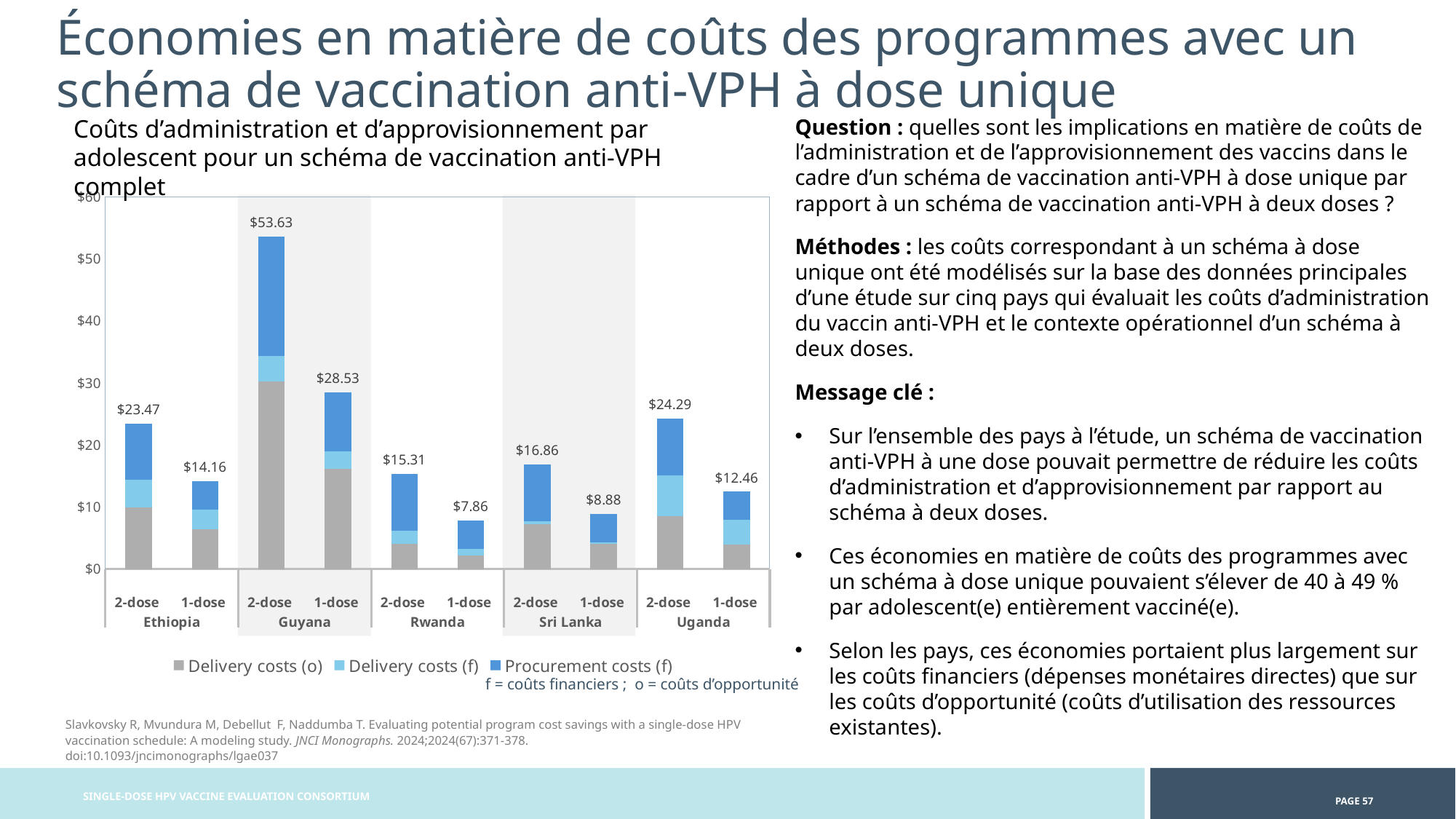
What is the total cost per adolescent for the 1-dose schedule in Rwanda? $7.86 How many series does the legend list? 3 What is the total cost per adolescent for the 1-dose schedule in Uganda? $12.46 What is the total cost per adolescent for the 2-dose schedule in Sri Lanka? $16.86 What is the difference between the 2-dose and 1-dose total costs in Guyana? $25.10 What is the total cost per adolescent for the 2-dose schedule in Guyana? $53.63 Which is larger: the 1-dose total cost in Ethiopia or the 1-dose total cost in Uganda? Ethiopia 1-dose What kind of chart is shown on the slide? Stacked bar chart Is the Delivery costs (o) segment for the 2-dose schedule in Uganda greater or less than $10? less Which country and schedule has the highest total cost per adolescent? Guyana 2-dose What is the difference between the 2-dose and 1-dose total costs in Ethiopia? $9.31 Which country and schedule has the lowest total cost per adolescent? Rwanda 1-dose